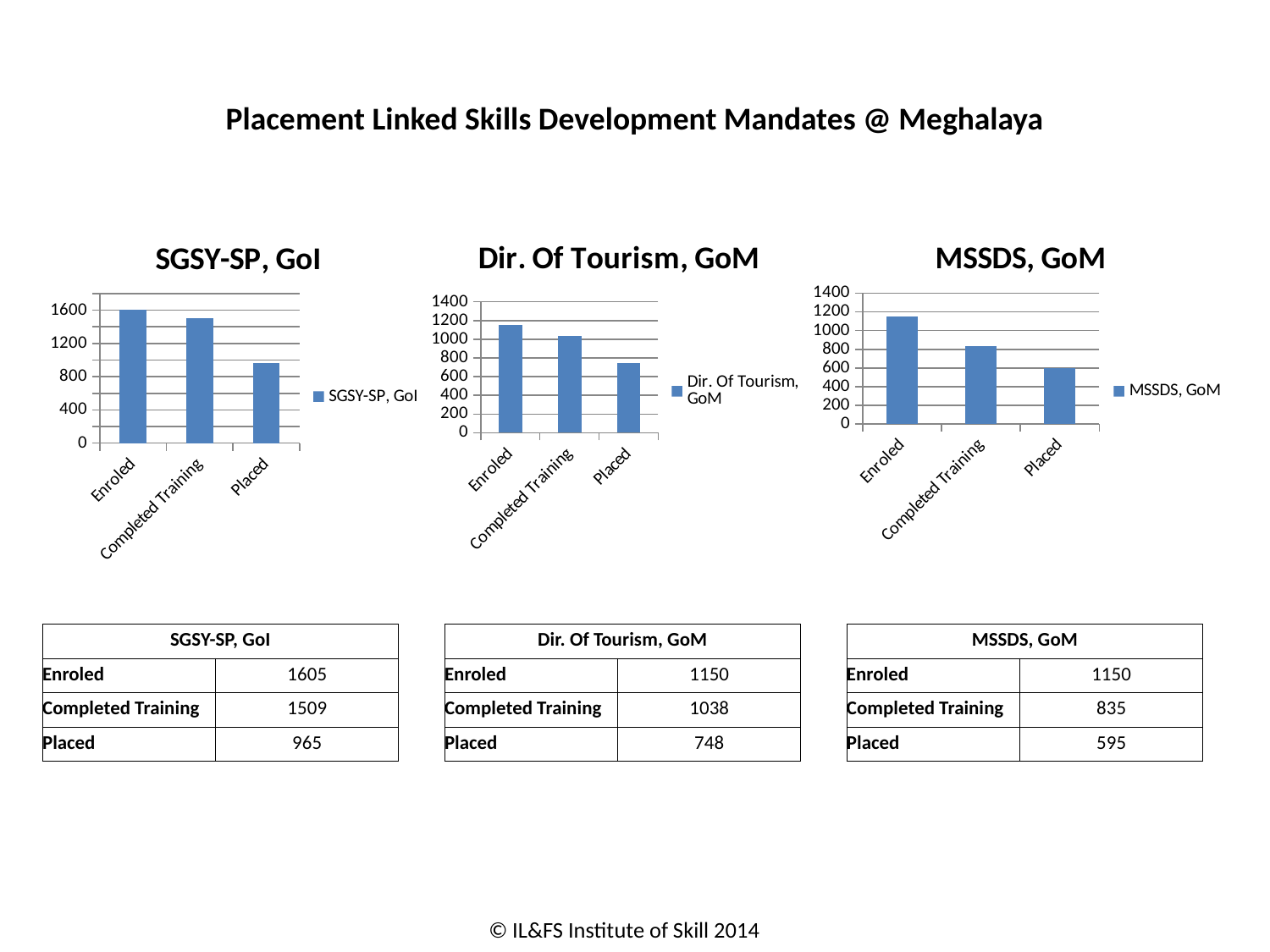
What kind of chart is the MSSDS, GoM chart? bar chart In the SGSY-SP, GoI chart, which category has the lowest value? Placed In the Dir. Of Tourism, GoM chart, what is the difference between Enroled and Completed Training? 112 In the MSSDS, GoM chart, which category has the highest value? Enroled In the Dir. Of Tourism, GoM chart, do the values rise or fall from Enroled to Placed? fall In the SGSY-SP, GoI chart, what is the value for Enroled? 1605 How many categories are shown on the x axis of the SGSY-SP, GoI chart? 3 In the MSSDS, GoM chart, is the value for Completed Training larger or smaller than the value for Placed? larger In the Dir. Of Tourism, GoM chart, what is the value for Placed? 748 In the Dir. Of Tourism, GoM chart, is the value for Placed greater or less than 800? less In the MSSDS, GoM chart, what is the value for Completed Training? 835 In the SGSY-SP, GoI chart, what is the difference between Completed Training and Placed? 544